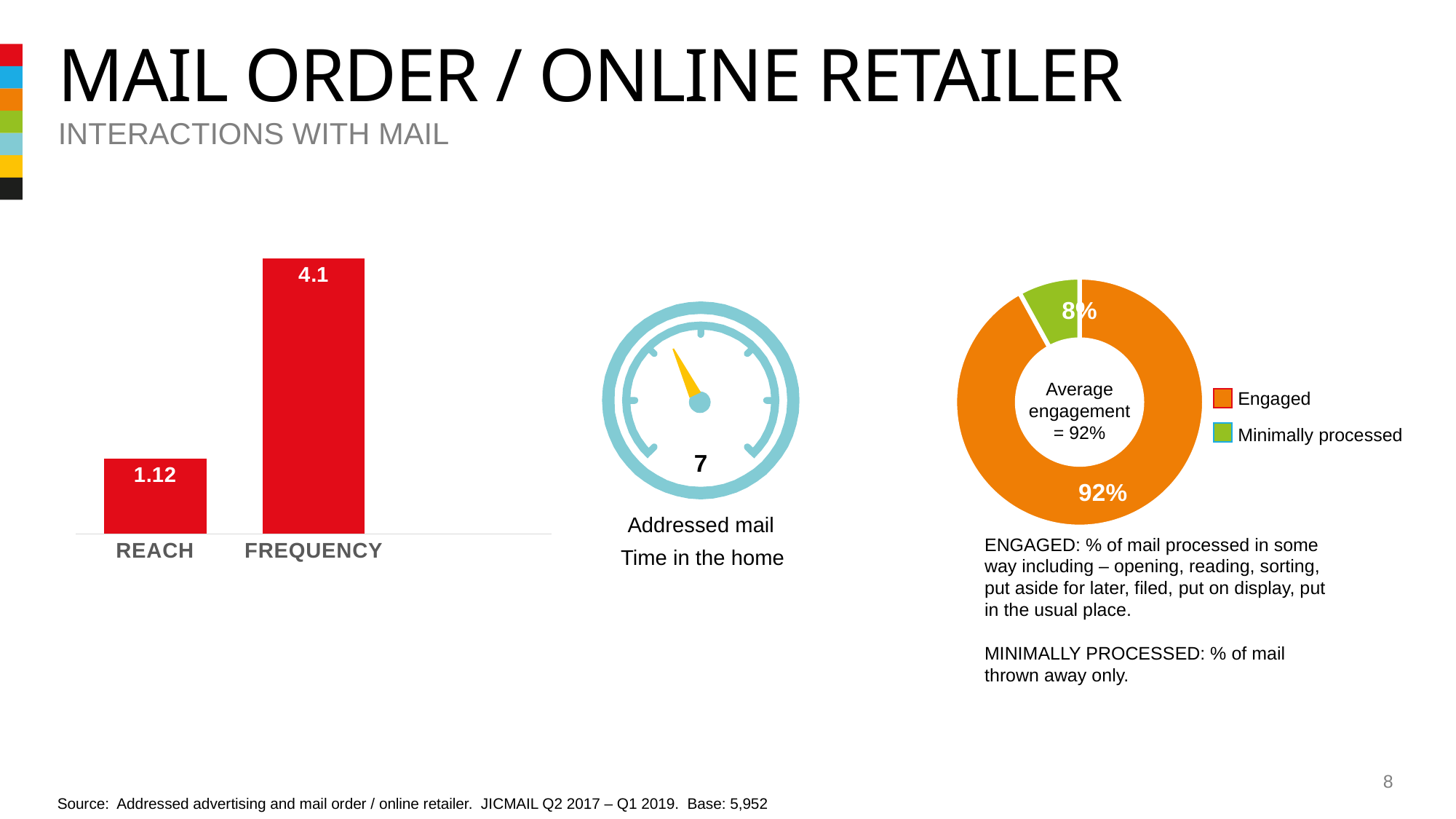
In the bar chart on the left, which category has the lower value? REACH In the bar chart on the left, what is the value for REACH? 1.12 In the doughnut chart on the right, what colour is the Minimally processed segment? Green In the bar chart on the left, what is the value for FREQUENCY? 4.1 In the doughnut chart on the right, which segment is larger, Engaged or Minimally processed? Engaged In the doughnut chart on the right, what share is labelled Minimally processed? 8% How many entries does the legend of the doughnut chart on the right list? 2 In the doughnut chart on the right, what share is labelled Engaged? 92% In the bar chart on the left, what is the difference between the FREQUENCY and REACH values? 2.98 In the bar chart on the left, which category has the higher value? FREQUENCY What kind of chart is the chart on the left of the slide? Bar chart In the bar chart on the left, how many categories are shown? 2